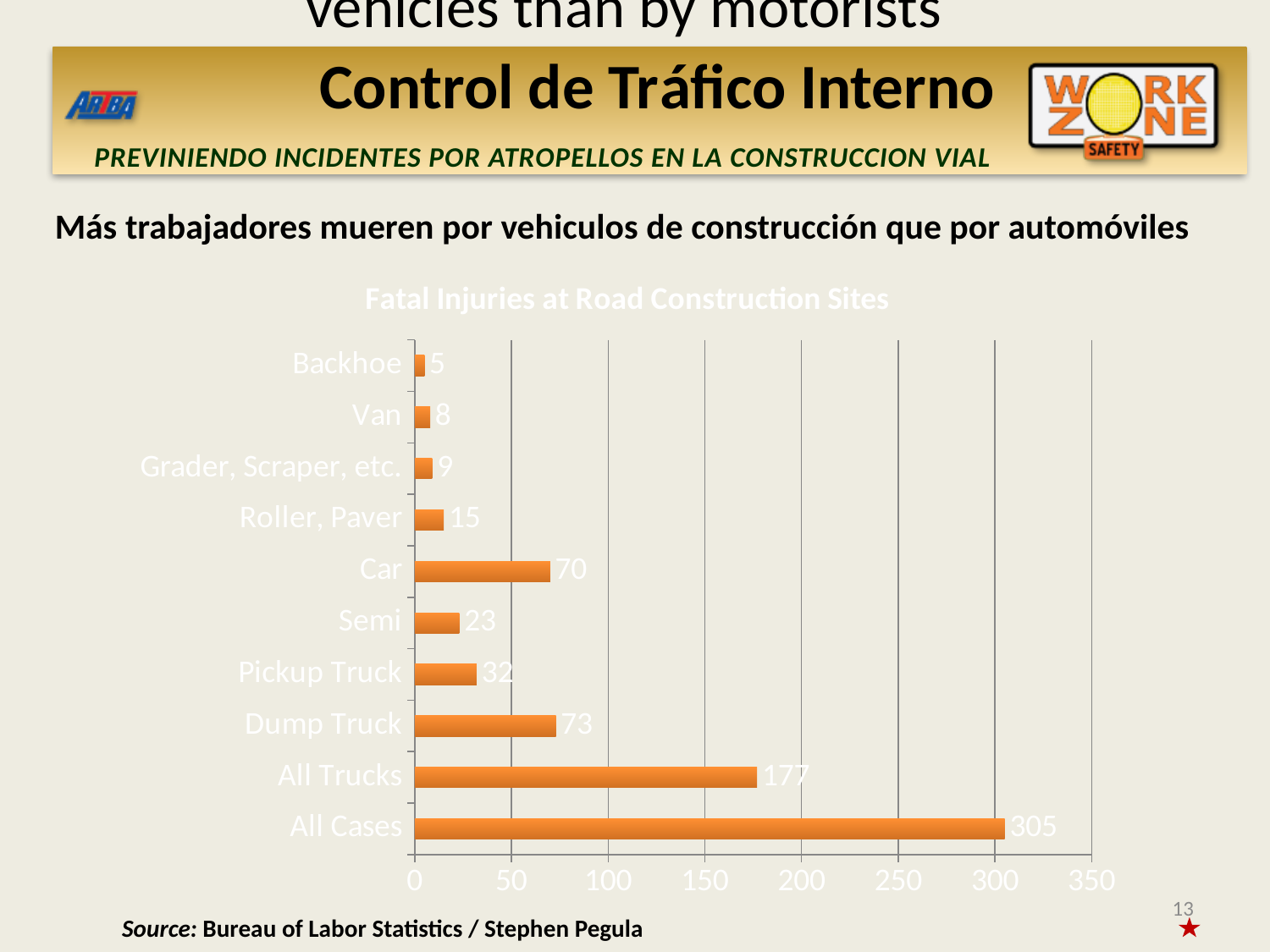
What is the difference between the values for Pickup Truck and Semi? 9 Which is larger, the value for Dump Truck or the value for Car? Dump Truck How many categories are shown in the chart? 10 Which category has the lowest value in the chart? Backhoe What is the difference between the values for All Cases and All Trucks? 128 What is the value for Dump Truck in the Fatal Injuries at Road Construction Sites chart? 73 What is the value for All Trucks in the chart? 177 Is the value for All Trucks greater or less than 150? greater What is the value for Car in the chart? 70 What is the title of the chart? Fatal Injuries at Road Construction Sites What kind of chart is shown on the slide? bar chart Which category has the highest value in the chart? All Cases